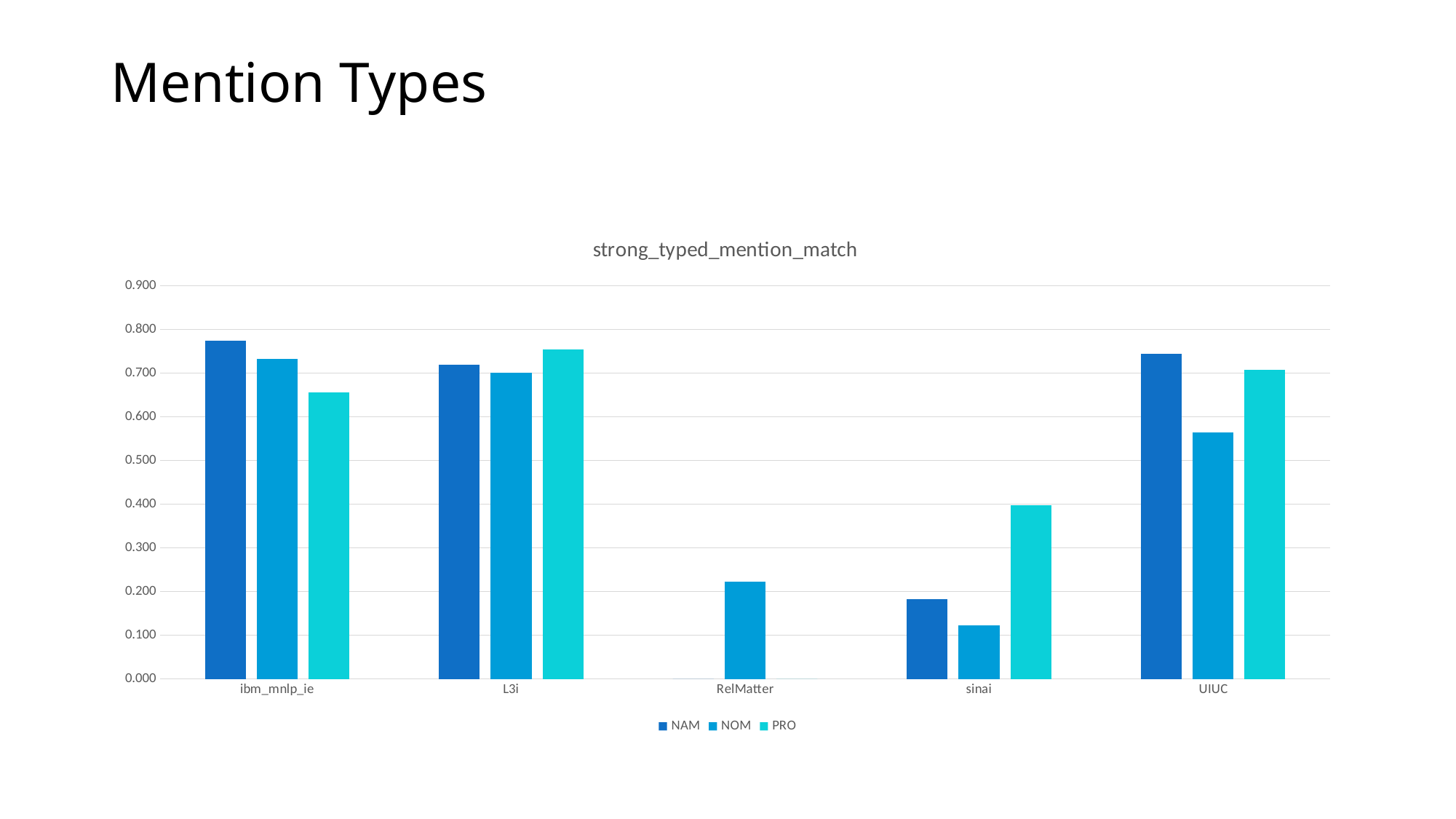
How many series does the legend list? 3 Which category has the lowest NOM value? sinai Is the NOM value for RelMatter greater or less than 0.300? less What is the title of the chart? strong_typed_mention_match Which category has the highest PRO value? L3i Which is larger for UIUC, the NAM value or the NOM value? NAM Is the NOM value for UIUC greater or less than 0.600? less Is the PRO value for sinai greater or less than 0.300? greater Which is larger for sinai, the PRO value or the NAM value? PRO How many categories are shown on the x axis? 5 What type of chart is shown on the slide? bar chart